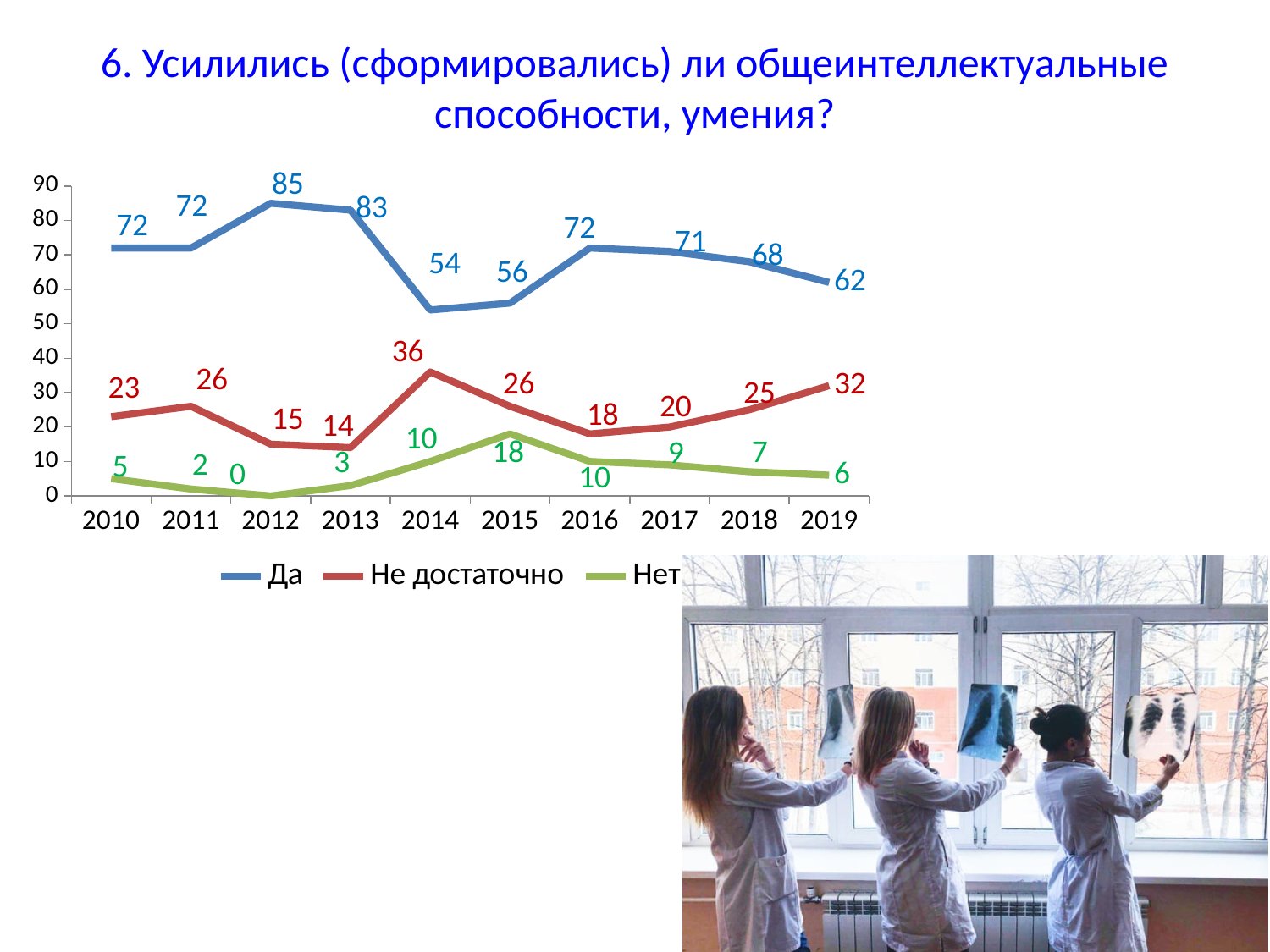
In which year is the "Да" series at its lowest? 2014 In which year is the "Не достаточно" series at its highest? 2014 How many series does the legend list? 3 Is the value for "Да" in 2013 greater or less than 80? greater What is the value for "Не достаточно" in 2014? 36 Which is larger in 2019: the value for "Не достаточно" or the value for "Нет"? Не достаточно Does the "Да" series rise or fall from 2016 to 2019? fall What is the difference between the "Да" values in 2012 and 2014? 31 What is the value for "Нет" in 2015? 18 How many years are shown on the x axis? 10 What kind of chart is shown on the slide? line chart What is the value for "Да" in 2012? 85